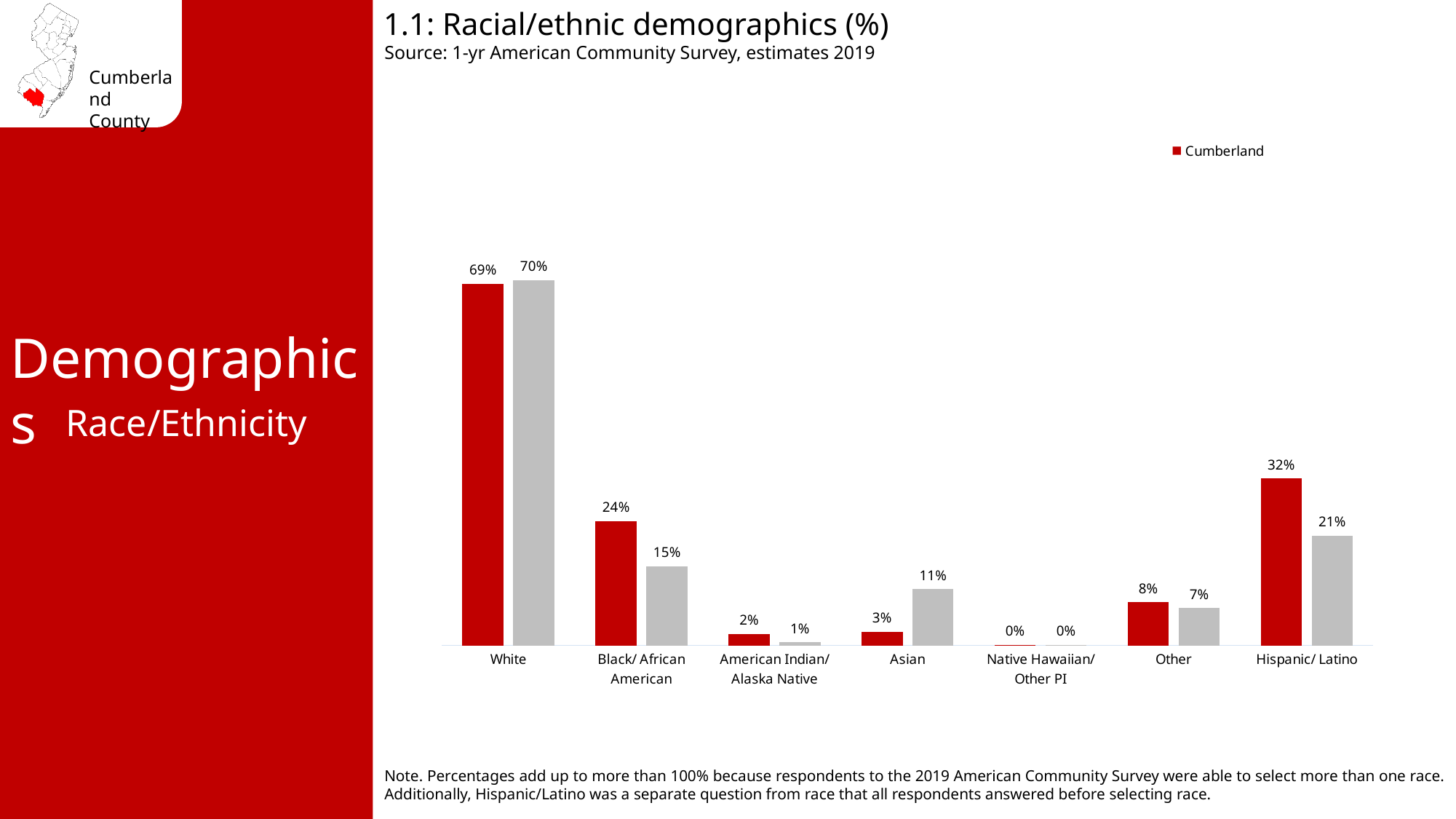
What is the difference between the Cumberland value and the gray bar value for Hispanic/ Latino? 11 percentage points For Asian, which is larger: the Cumberland bar or the gray bar? The gray bar Which category has the lowest Cumberland value? Native Hawaiian/ Other PI What kind of chart is shown on the slide? Bar chart What is the value of the gray bar for Asian? 11% What is the title of the chart? 1.1: Racial/ethnic demographics (%) What is the Cumberland value for White? 69% How many series does the legend list? 1 Which category has the highest Cumberland value? White How many categories are shown on the x axis? 7 What is the difference between the Cumberland value and the gray bar value for Black/ African American? 9 percentage points What is the Cumberland value for Hispanic/ Latino? 32%